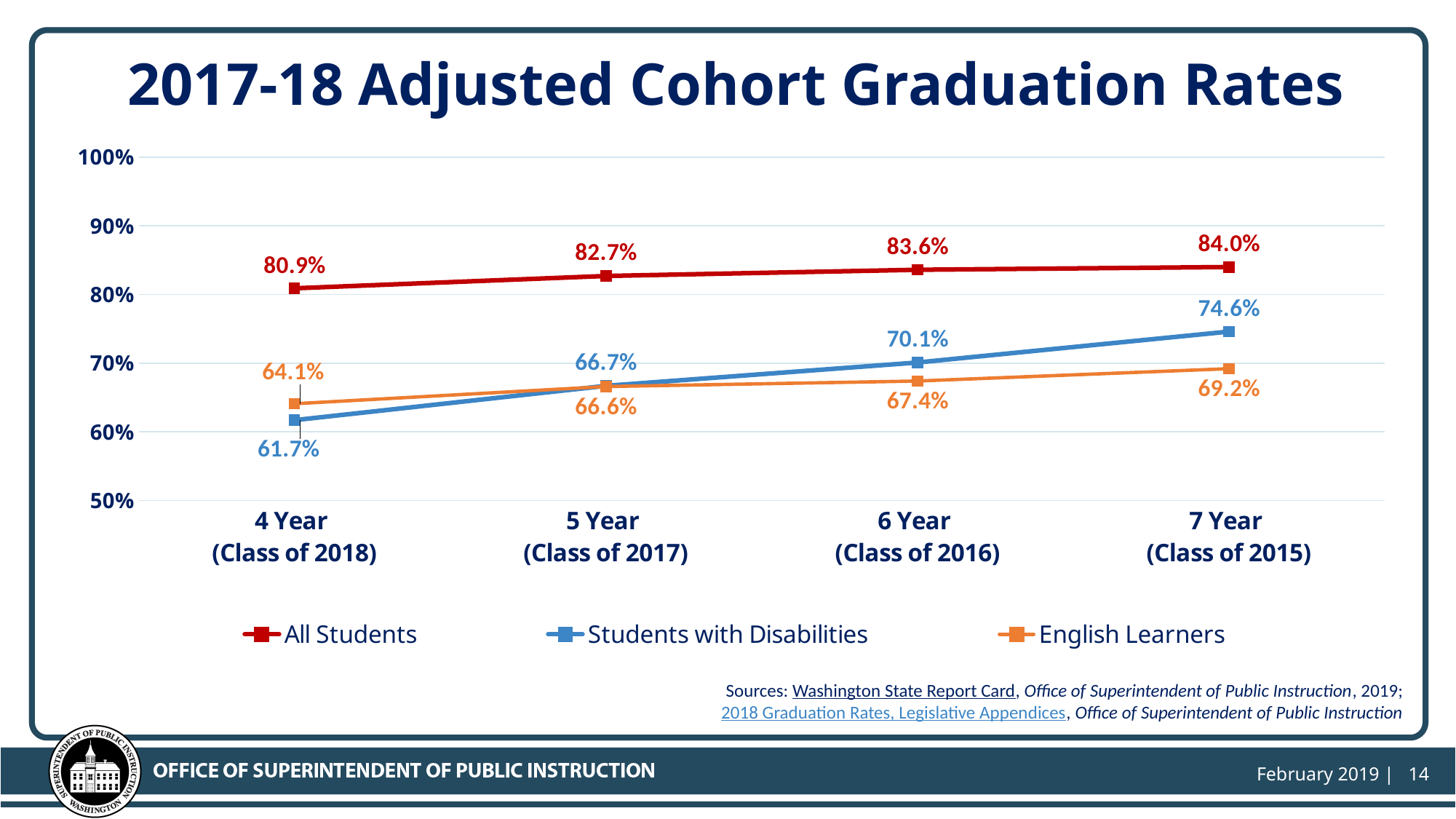
What is the 6 Year (Class of 2016) graduation rate for English Learners? 67.4% How many cohort categories are shown on the x axis? 4 Which is larger for the 7 Year (Class of 2015) cohort: the Students with Disabilities rate or the English Learners rate? Students with Disabilities What is the difference between the All Students rate and the Students with Disabilities rate for the 4 Year (Class of 2018) cohort? 19.2% What is the 4 Year (Class of 2018) graduation rate for All Students? 80.9% How many series does the legend list? 3 What kind of chart is shown on the slide? Line chart Is the 5 Year (Class of 2017) rate for All Students greater or less than 80%? greater Which cohort has the highest graduation rate for All Students? 7 Year (Class of 2015) Does the Students with Disabilities graduation rate rise or fall from the 4 Year cohort to the 7 Year cohort? Rise What is the 7 Year (Class of 2015) graduation rate for Students with Disabilities? 74.6% Which cohort has the lowest graduation rate for Students with Disabilities? 4 Year (Class of 2018)